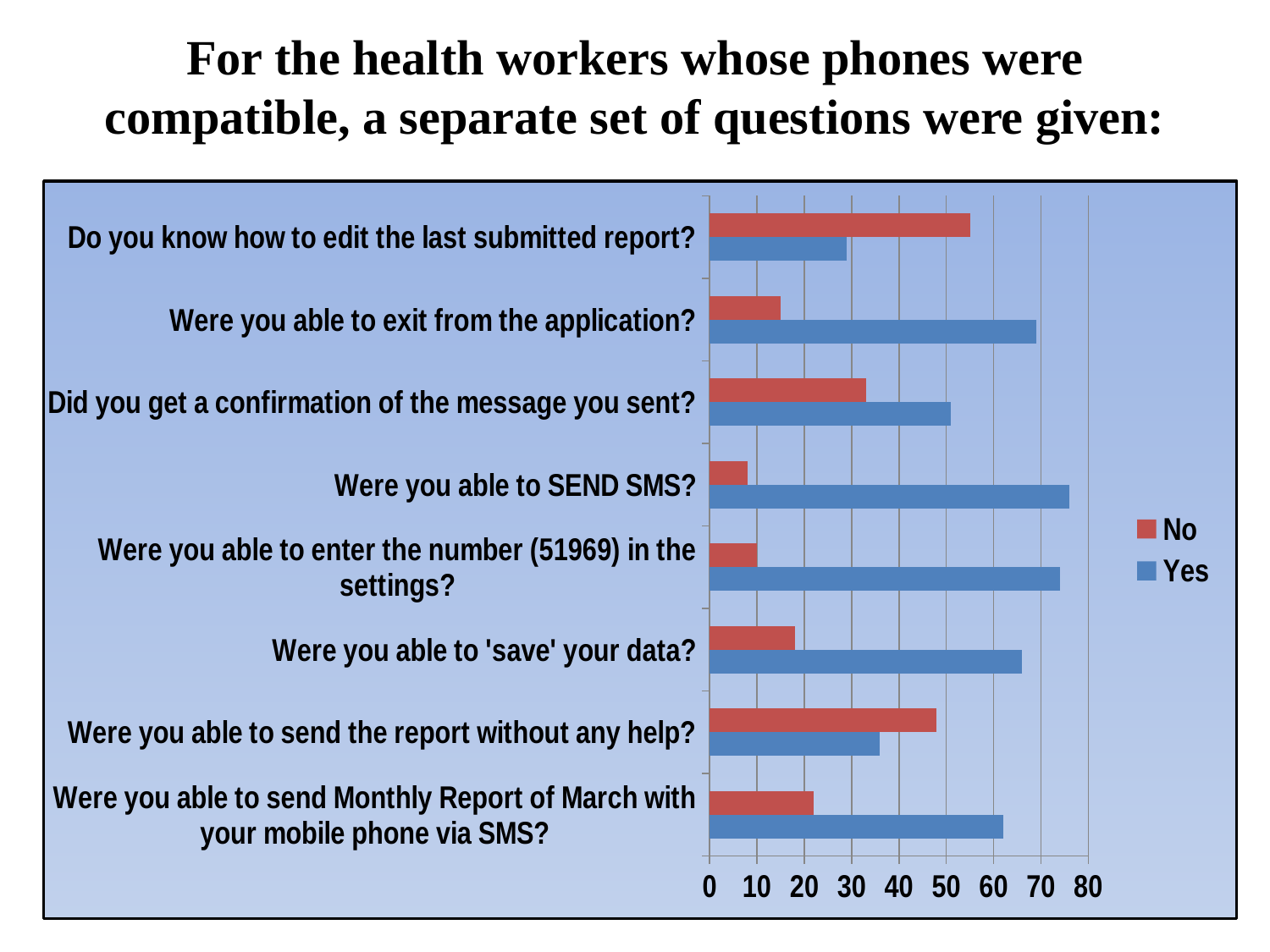
How many series does the legend list? 2 Which question has the highest 'No' value? Do you know how to edit the last submitted report? Which question has the lowest 'Yes' value? Do you know how to edit the last submitted report? Is the 'No' value for 'Do you know how to edit the last submitted report?' greater or less than 50? greater Which colour represents the 'Yes' series in the chart? blue Is the 'Yes' value for 'Were you able to SEND SMS?' greater or less than 70? greater How many questions (categories) are plotted on the chart? 8 Is the 'No' value for 'Did you get a confirmation of the message you sent?' greater or less than 40? less For 'Were you able to "save" your data?', which is larger, the 'Yes' value or the 'No' value? Yes For 'Were you able to send the report without any help?', which is larger, the 'No' value or the 'Yes' value? No What kind of chart is shown on the slide? bar chart